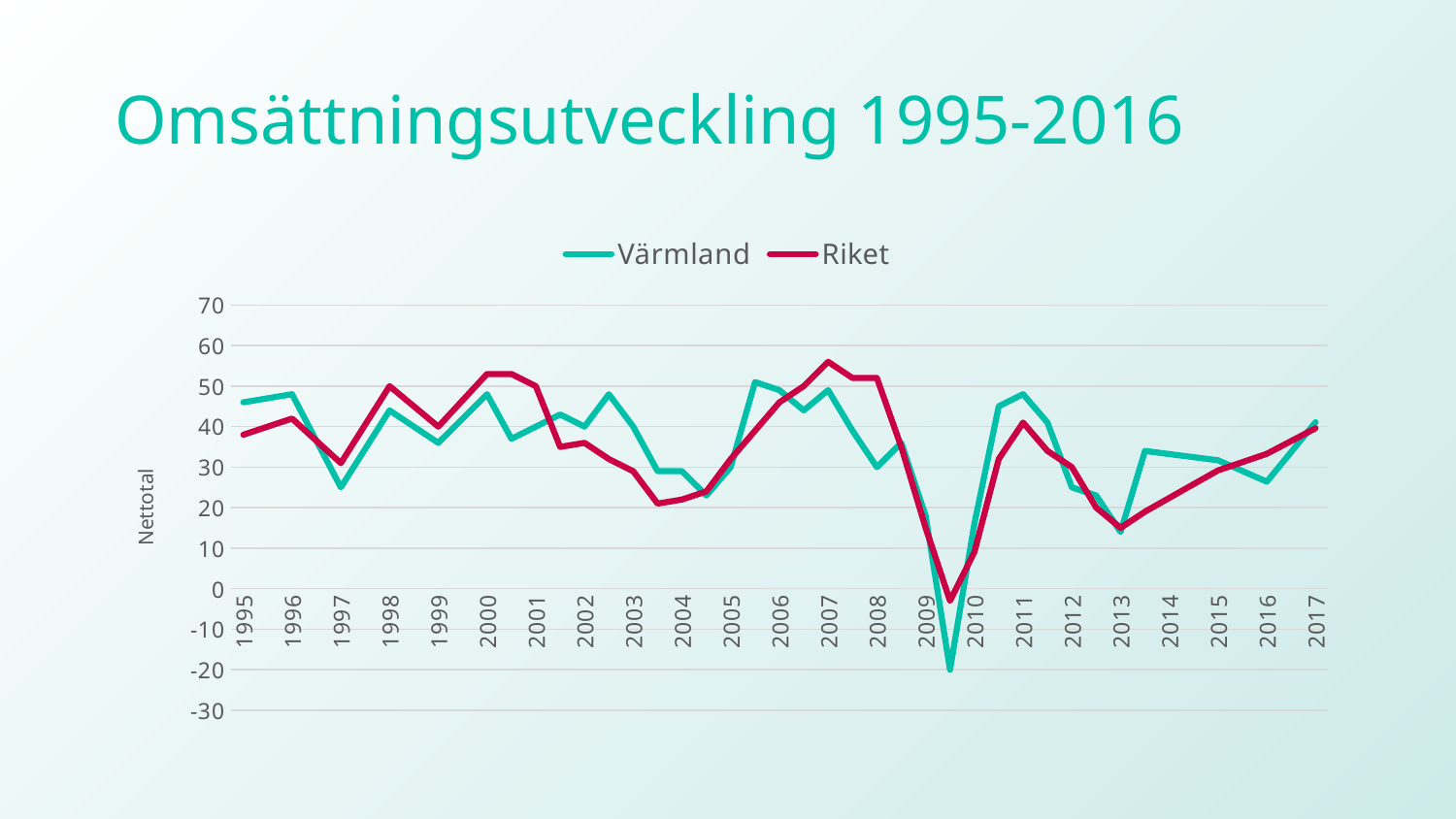
Is the value for Riket in 2007 greater or less than 50? greater What kind of chart is shown on the slide? line chart How many years are labelled on the x axis? 23 In which year does the Riket series reach its highest value? 2007 Is the value for Värmland in 2009 greater or less than 0? less Is the value for Riket in 2004 greater or less than 30? less Does the Riket series rise or fall from 2013 to 2017? rise How many series does the legend list? 2 Which two series are shown in the legend? Värmland and Riket What is the title of the chart? Omsättningsutveckling 1995-2016 In 2003, which series has the higher value, Värmland or Riket? Värmland In which year does the Värmland series reach its lowest value? 2009